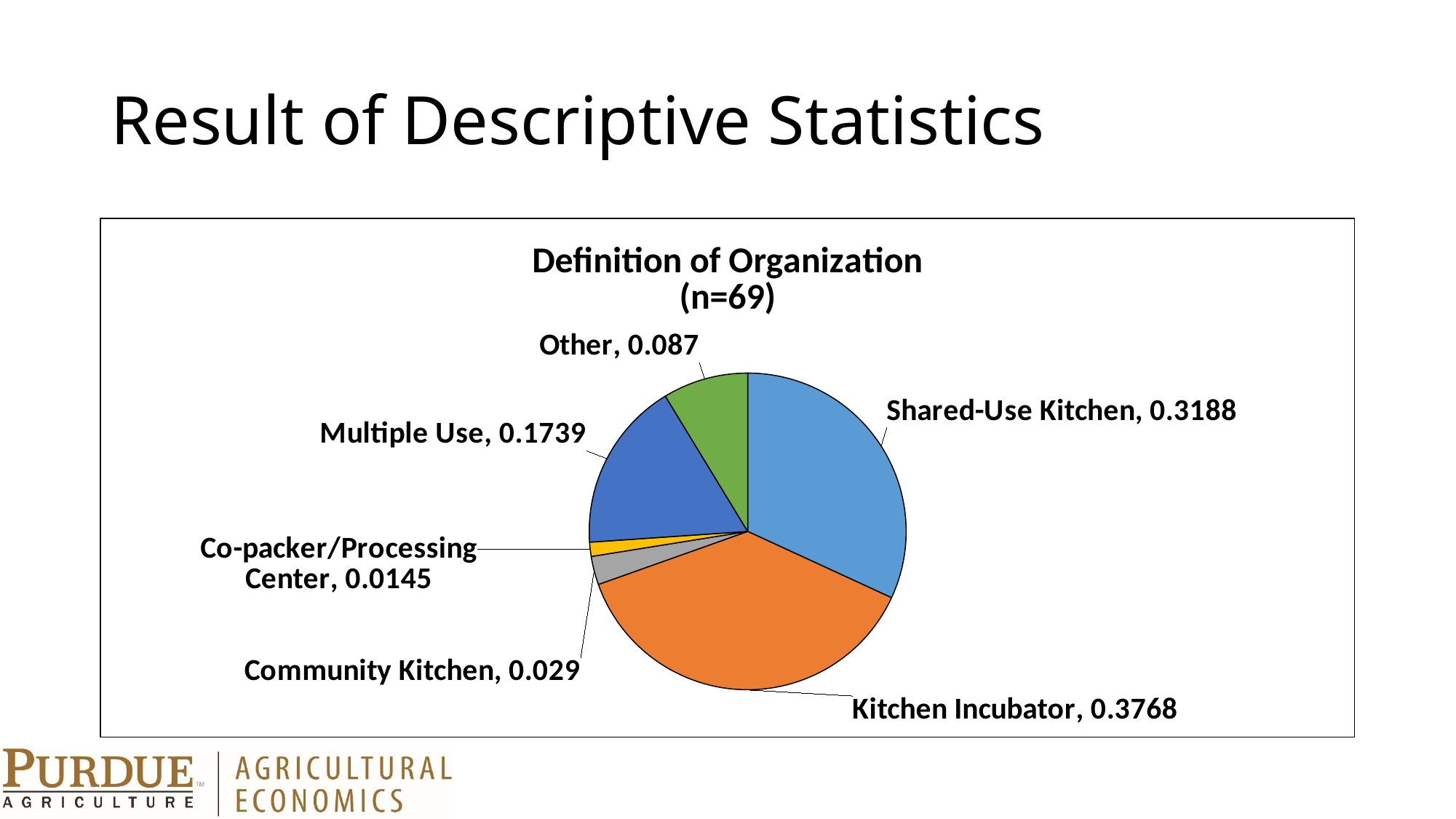
What is the value shown for Kitchen Incubator? 0.3768 How many categories are shown in the pie chart? 6 What is the difference between the values for Kitchen Incubator and Shared-Use Kitchen? 0.058 Which category has the largest slice of the pie? Kitchen Incubator Which is larger, the value for Multiple Use or the value for Other? Multiple Use What kind of chart is shown on the slide? Pie chart What is the value shown for Shared-Use Kitchen? 0.3188 What is the value shown for Co-packer/Processing Center? 0.0145 Which category has the smallest slice of the pie? Co-packer/Processing Center What colour is the Kitchen Incubator slice? Orange What is the value shown for Multiple Use? 0.1739 What is the title of the chart? Definition of Organization (n=69)